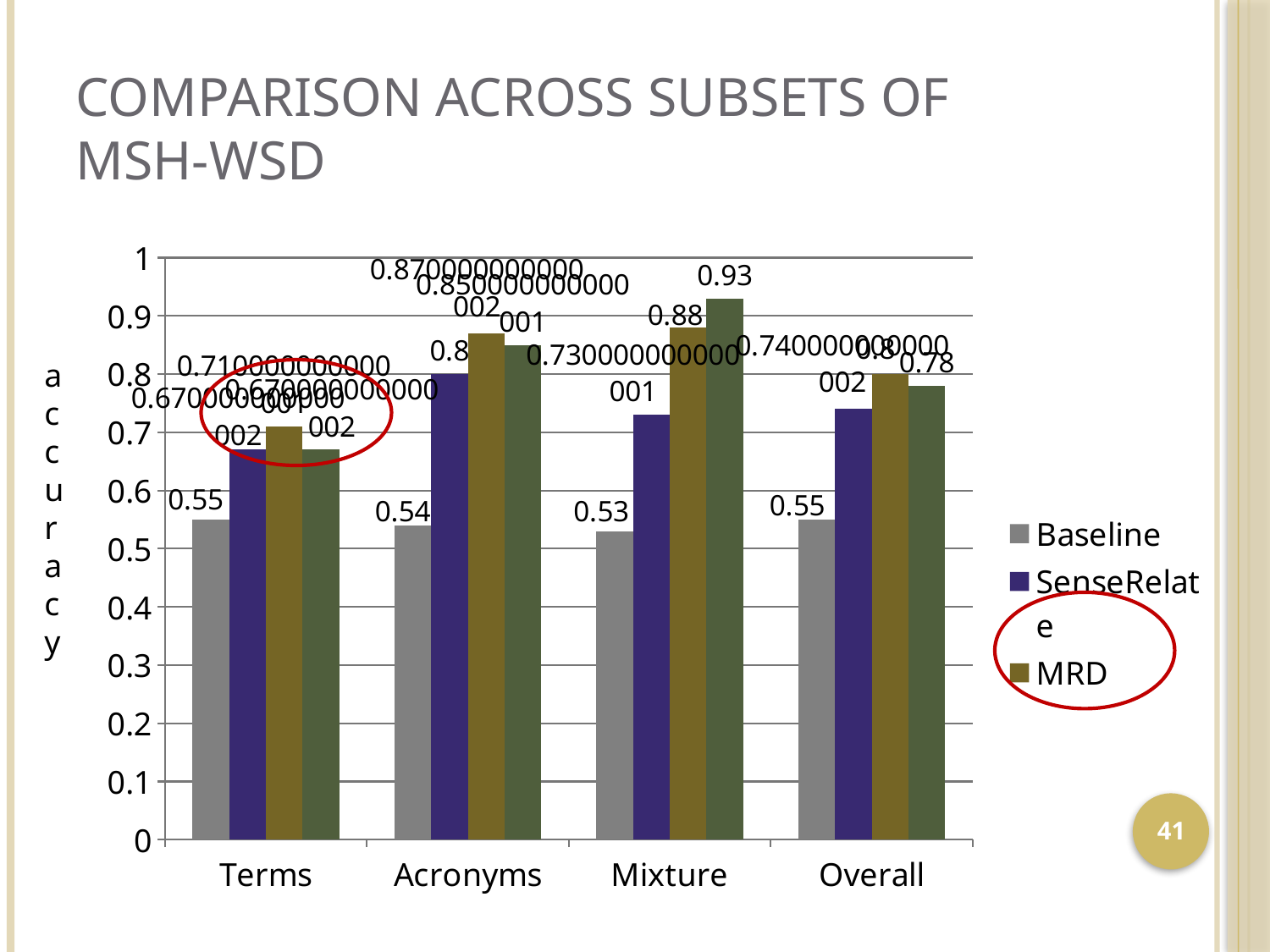
How many categories are shown on the x axis? 4 What is the Baseline value for Terms? 0.55 What kind of chart is shown on the slide? bar chart What is the Baseline value for Mixture? 0.53 What is the MRD value for Overall? 0.8 What is the SenseRelate value for Acronyms? 0.8 What is the difference between the MRD value and the Baseline value for Mixture? 0.35 For which category is the Baseline value lowest? Mixture Is the SenseRelate value for Mixture greater or less than 0.8? less For which category is the MRD value highest? Mixture Which is larger, the MRD value for Mixture or the MRD value for Overall? MRD value for Mixture What is the MRD value for Mixture? 0.88